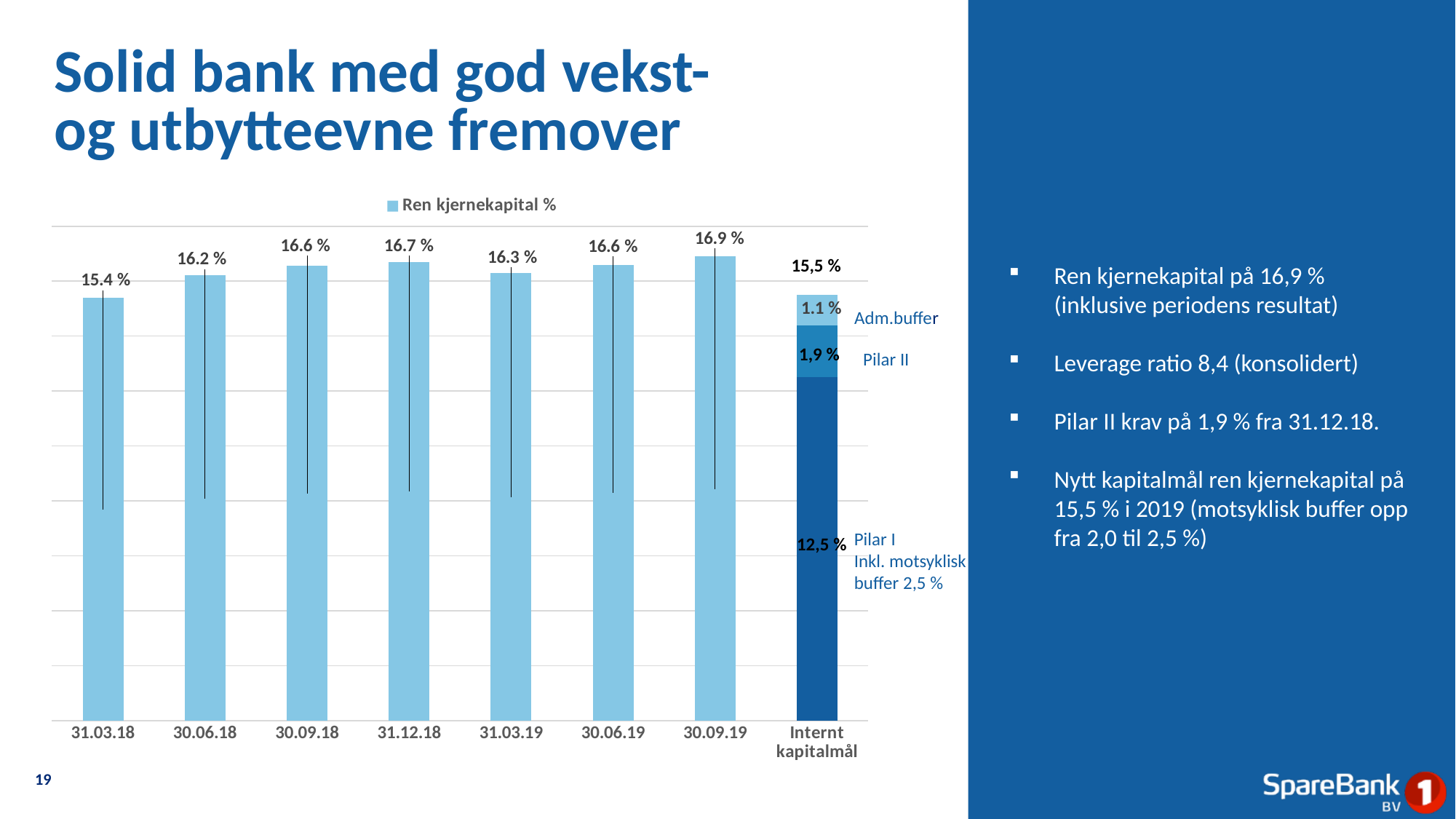
What is the Adm.buffer value in the Internt kapitalmål bar? 1.1 % What is the difference between the Ren kjernekapital % for 30.09.19 and 31.03.18? 1.5 % Which date has the lowest Ren kjernekapital %? 31.03.18 What kind of chart is shown on the slide? Bar chart What is the Pilar I value in the Internt kapitalmål bar? 12,5 % How many bars are shown on the x axis of the chart? 8 What is the value of Ren kjernekapital % for 31.03.19? 16.3 % What is the value of Ren kjernekapital % for 31.03.18? 15.4 % Which date has the highest Ren kjernekapital %? 30.09.19 What is the total of the stacked Internt kapitalmål bar? 15,5 % Which is larger, the Ren kjernekapital % for 31.12.18 or for 31.03.19? 31.12.18 What is the value of Ren kjernekapital % for 30.09.19? 16.9 %